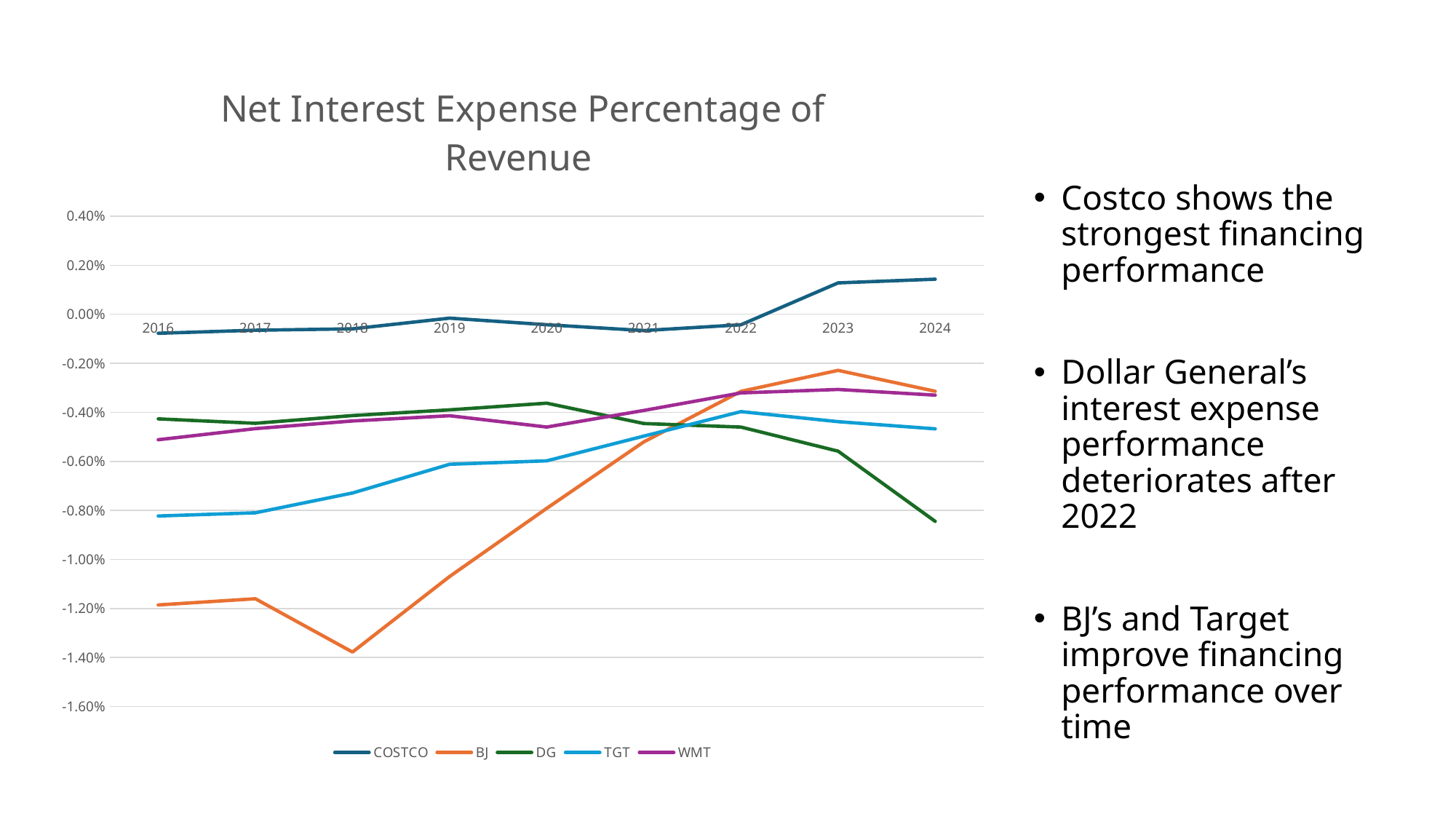
Does the DG line rise or fall from 2022 to 2024? fall Which series has the lowest value in 2016? BJ Which series has the lowest value in 2024? DG In 2024, which is higher, TGT or DG? TGT Is the value for BJ in 2018 greater or less than -1.20%? less How many series does the legend list? 5 How many years are plotted along the x axis? 9 Is the value for TGT in 2016 greater or less than -1.00%? greater Is the value for COSTCO in 2023 greater or less than 0.00%? greater In which year does the BJ line reach its lowest value? 2018 What kind of chart is shown on the slide? line chart Which series has the highest value in 2024? COSTCO